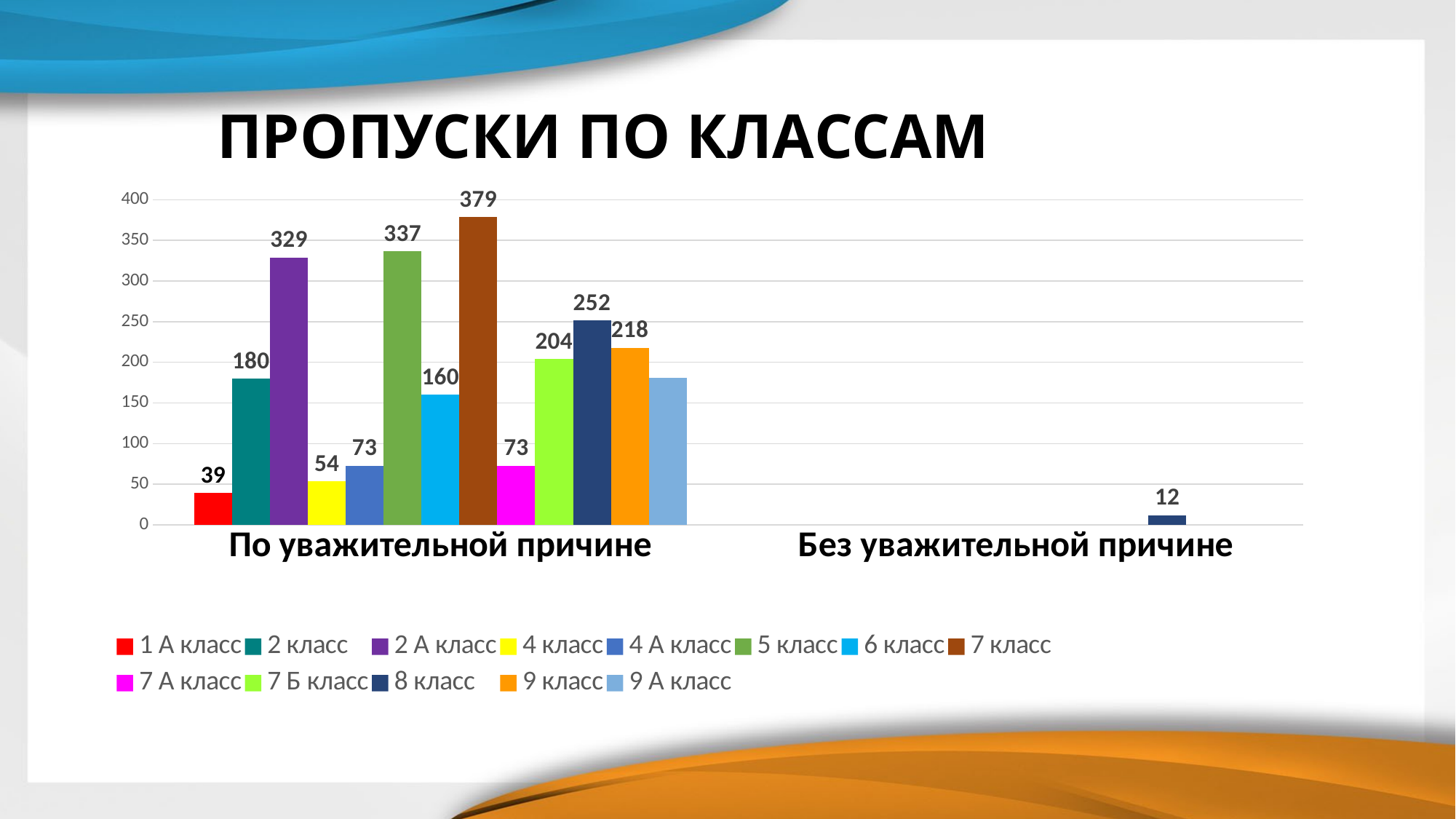
Is the value for 9 А класс in the По уважительной причине category greater or less than 150? greater What is the value for 7 класс in the По уважительной причине category? 379 Which series has the lowest value in the По уважительной причине category? 1 А класс How many categories are shown on the x axis? 2 What is the value for 8 класс in the Без уважительной причине category? 12 In the По уважительной причине category, which is larger: the value for 8 класс or the value for 9 класс? 8 класс What is the value for 2 А класс in the По уважительной причине category? 329 What is the difference between the values for 7 класс and 5 класс in the По уважительной причине category? 42 Which series has the highest value in the По уважительной причине category? 7 класс What kind of chart is shown on the slide? bar chart How many series does the legend list? 13 What is the title of the slide? ПРОПУСКИ ПО КЛАССАМ